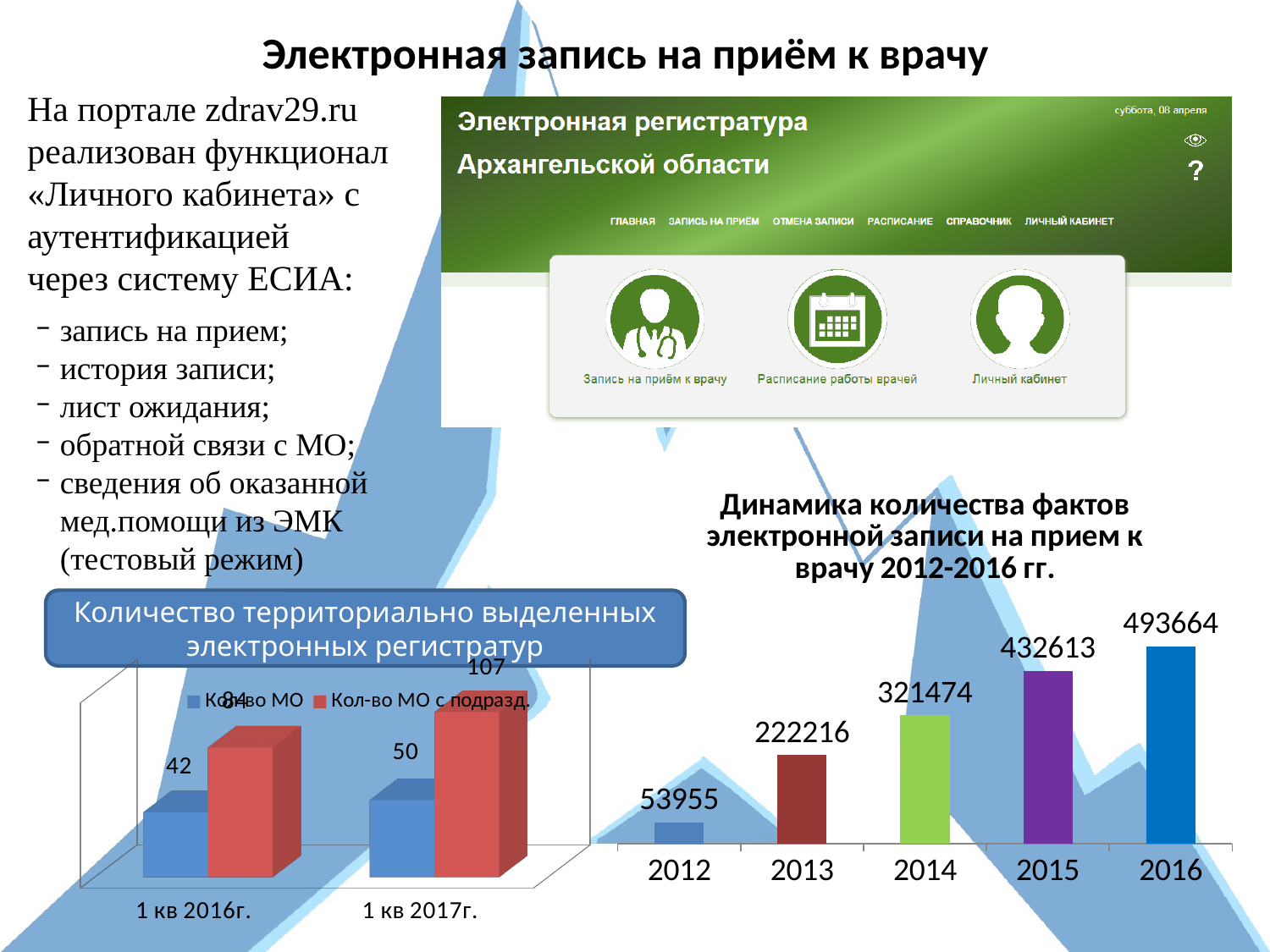
In the chart 'Количество территориально выделенных электронных регистратур', what is the value of 'Кол-во МО с подразд.' for 1 кв 2017г.? 107 In the chart 'Количество территориально выделенных электронных регистратур', which is larger for 1 кв 2016г.: 'Кол-во МО' or 'Кол-во МО с подразд.'? Кол-во МО с подразд. In the chart 'Количество территориально выделенных электронных регистратур', what is the value of 'Кол-во МО' for 1 кв 2017г.? 50 In the chart 'Динамика количества фактов электронной записи на прием к врачу 2012-2016 гг.', which year has the highest value? 2016 What kind of chart is 'Динамика количества фактов электронной записи на прием к врачу 2012-2016 гг.'? bar chart In the chart 'Количество территориально выделенных электронных регистратур', how many series does the legend list? 2 In the chart 'Динамика количества фактов электронной записи на прием к врачу 2012-2016 гг.', do the values rise or fall from 2012 to 2016? rise In the chart 'Динамика количества фактов электронной записи на прием к врачу 2012-2016 гг.', what is the value for 2012? 53955 In the chart 'Динамика количества фактов электронной записи на прием к врачу 2012-2016 гг.', what is the value for 2014? 321474 In the chart 'Динамика количества фактов электронной записи на прием к врачу 2012-2016 гг.', what is the difference between the values for 2016 and 2015? 61051 In the chart 'Динамика количества фактов электронной записи на прием к врачу 2012-2016 гг.', how many years are shown? 5 In the chart 'Динамика количества фактов электронной записи на прием к врачу 2012-2016 гг.', which year has the lowest value? 2012